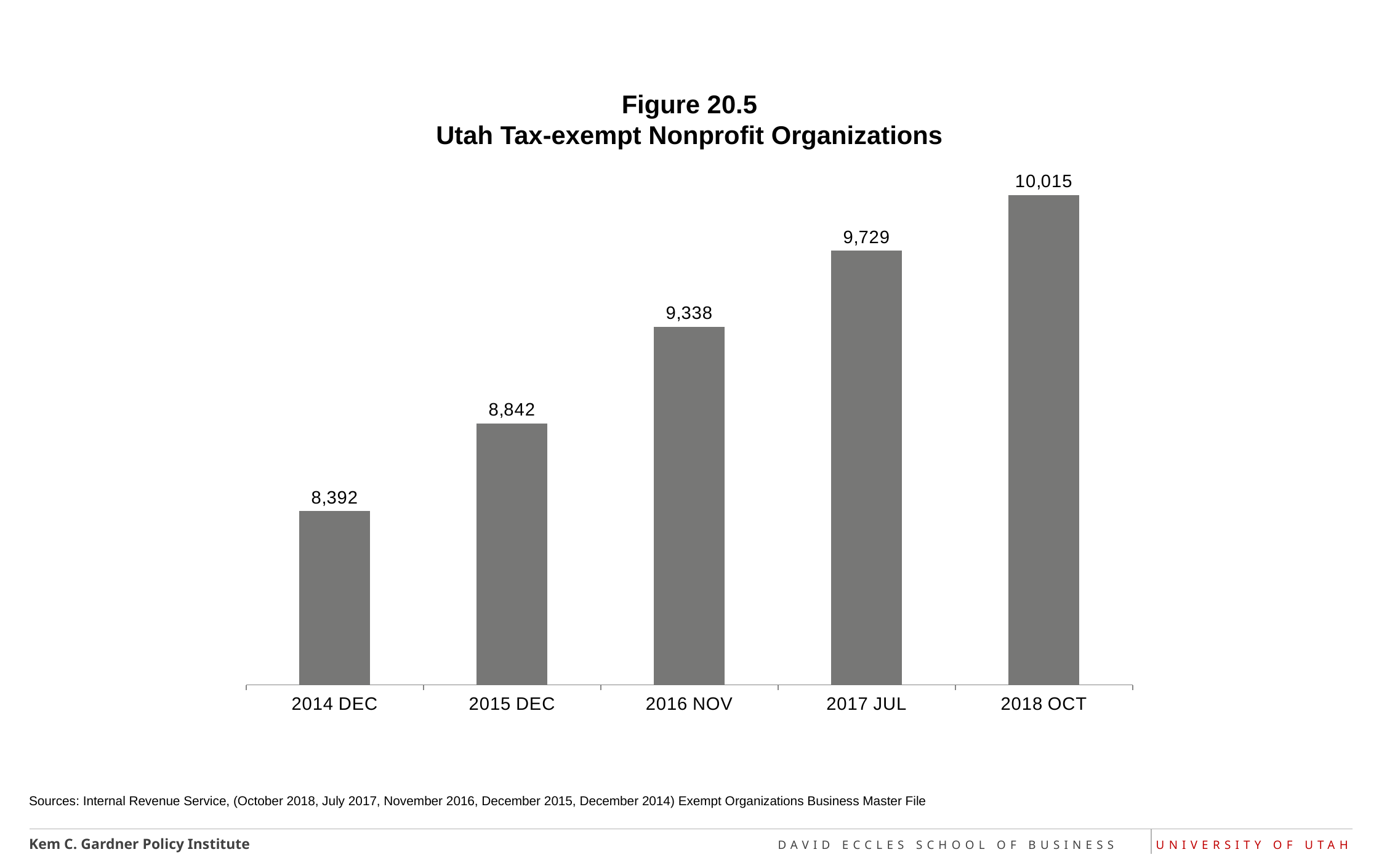
Which category has the highest value? 2018 OCT Which is larger, the value for 2015 DEC or the value for 2016 NOV? 2016 NOV What kind of chart is this? Bar chart What is the value for 2014 DEC? 8,392 What is the difference between the values for 2018 OCT and 2014 DEC? 1,623 What is the value for 2016 NOV? 9,338 What is the title of the chart? Figure 20.5 Utah Tax-exempt Nonprofit Organizations How many categories are shown on the x axis? 5 What is the value for 2018 OCT? 10,015 Do the values rise or fall from 2014 DEC to 2018 OCT? Rise Which category has the lowest value? 2014 DEC What is the difference between the values for 2017 JUL and 2016 NOV? 391